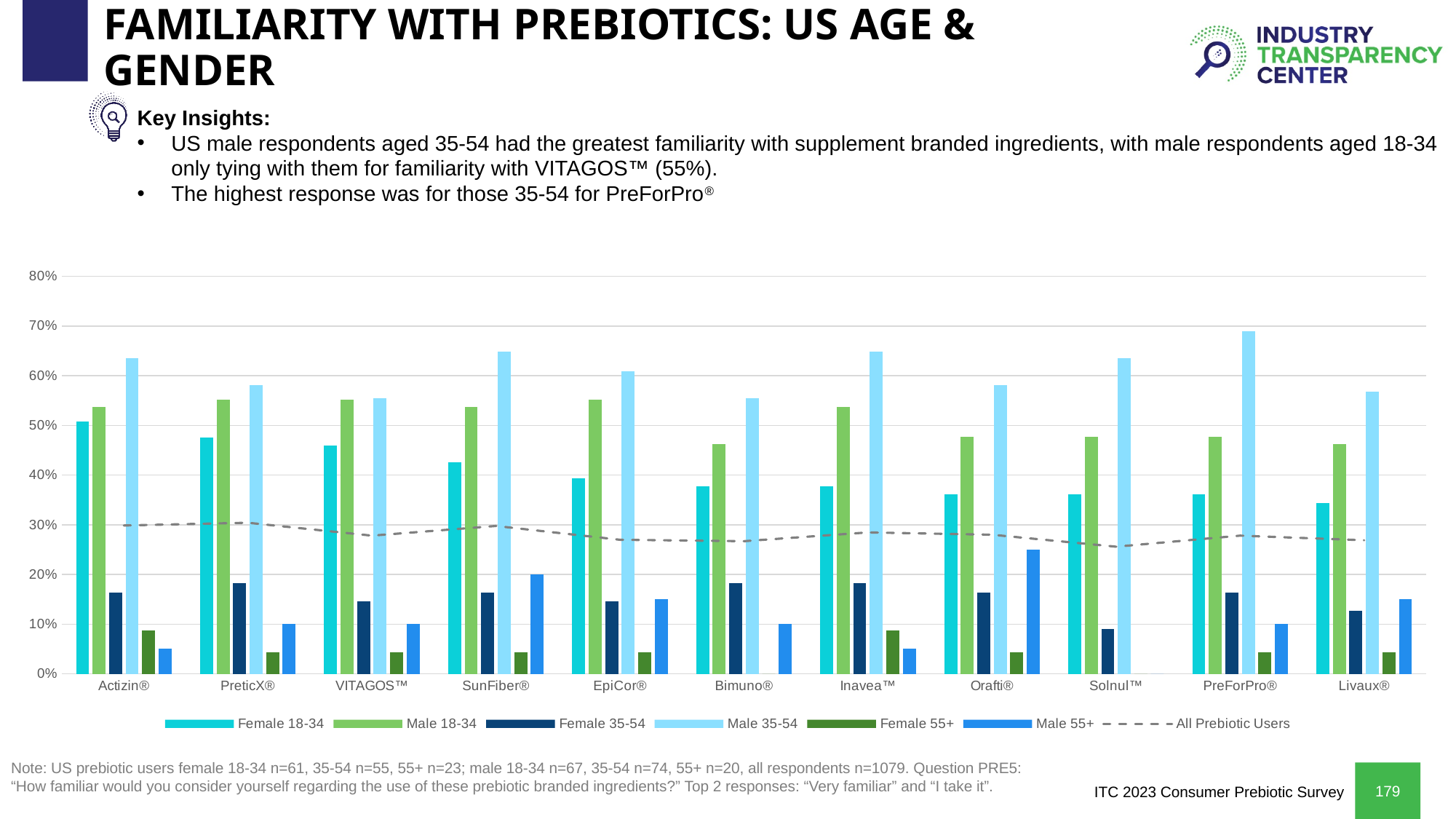
Is the Male 18-34 value for Livaux® greater or less than 40%? greater For SunFiber®, which is larger: the Male 55+ value or the Female 55+ value? Male 55+ How many branded ingredients are listed along the x axis of the chart? 11 Is the Male 35-54 value for PreForPro® greater or less than 60%? greater Which branded ingredient has the highest Female 18-34 bar? Actizin® Which branded ingredient has the highest Male 35-54 bar? PreForPro® Is the Female 55+ value for PreticX® greater or less than 10%? less What kind of chart is shown on the slide? Combination bar and line chart How many series does the chart legend list? 7 For Bimuno®, which is larger: the Male 18-34 value or the Female 18-34 value? Male 18-34 Which series in the legend is drawn as a dashed line rather than bars? All Prebiotic Users